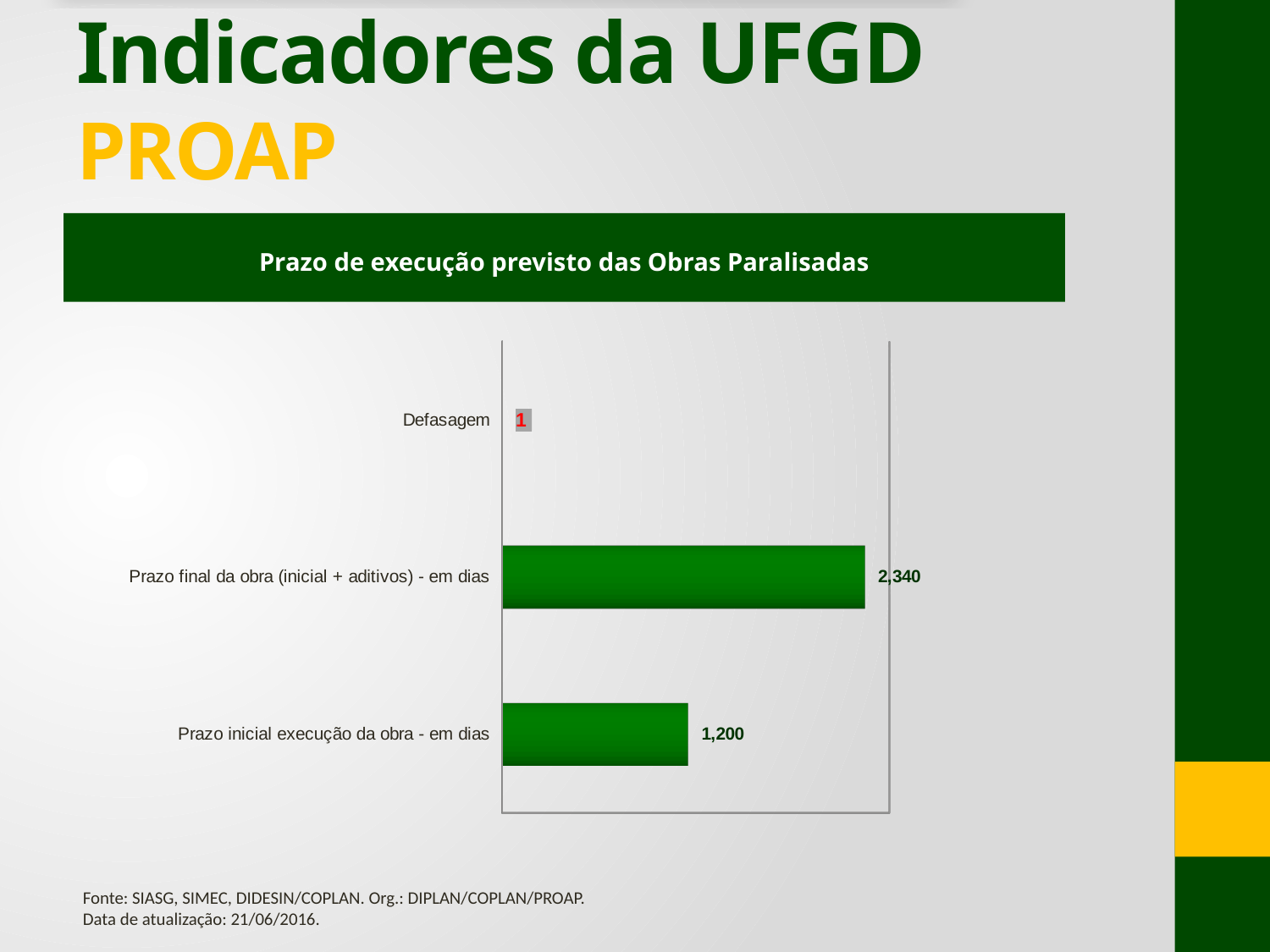
Which category has the highest value? Prazo final da obra (inicial + aditivos) - em dias Which category has the lowest value? Defasagem What is the value shown for "Defasagem"? 1 What is the title of the chart? Prazo de execução previsto das Obras Paralisadas What is the difference between the value for "Prazo final da obra (inicial + aditivos) - em dias" and the value for "Prazo inicial execução da obra - em dias"? 1,140 What is the value for "Prazo inicial execução da obra - em dias"? 1,200 How many categories are shown in the chart? 3 What is the value for "Prazo final da obra (inicial + aditivos) - em dias"? 2,340 What kind of chart is shown on the slide? Bar chart Which is larger: the value for "Prazo inicial execução da obra - em dias" or the value for "Prazo final da obra (inicial + aditivos) - em dias"? Prazo final da obra (inicial + aditivos) - em dias What colour is the data label for "Defasagem"? Red